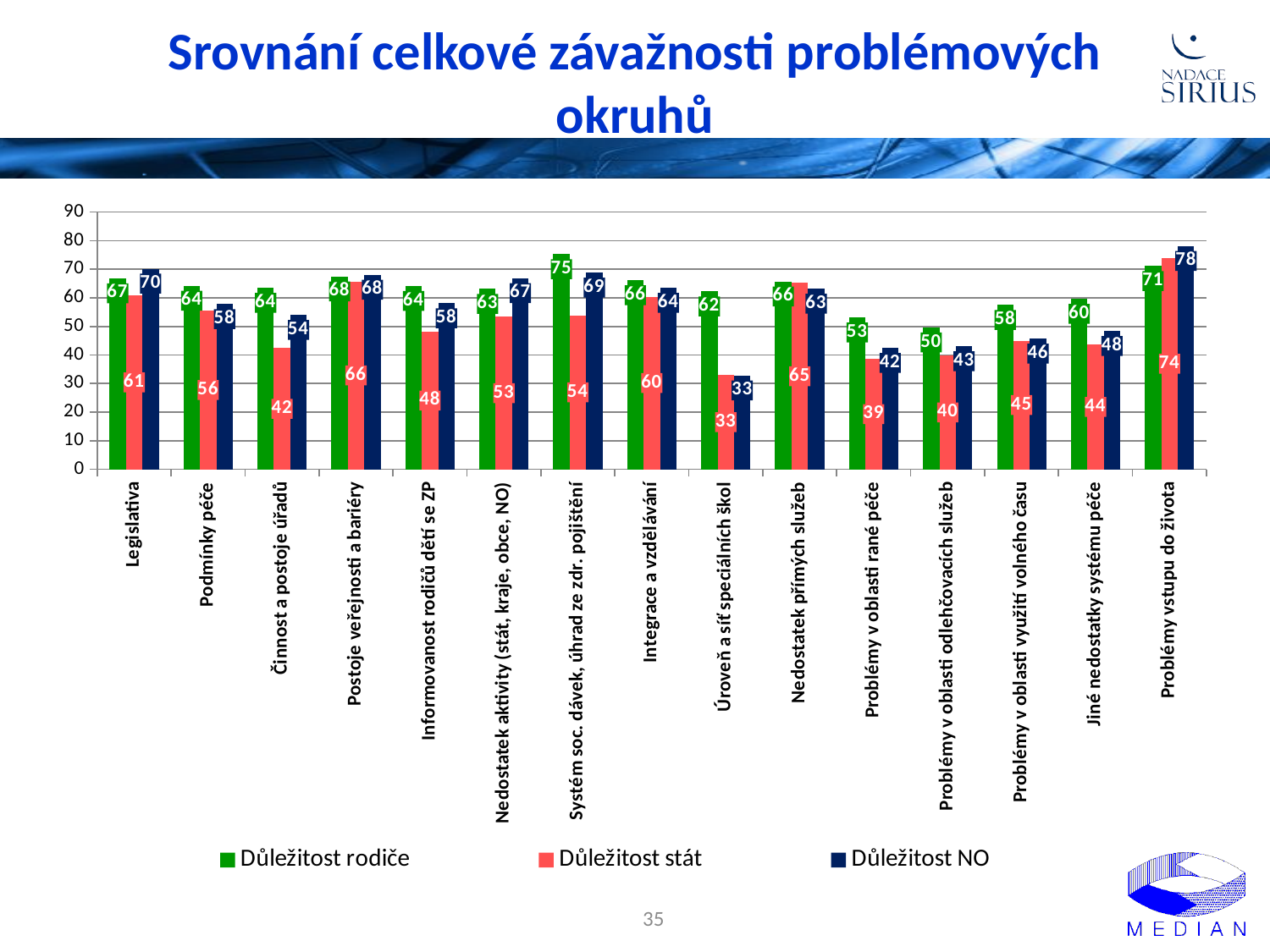
Is the value of Důležitost stát for Informovanost rodičů dětí se ZP greater or less than 50? less What is the value of Důležitost NO for Problémy vstupu do života? 78 What is the value of Důležitost rodiče for Legislativa? 67 What is the value of Důležitost stát for Činnost a postoje úřadů? 42 How many categories are shown on the x axis? 15 Which category has the lowest value for Důležitost rodiče? Problémy v oblasti odlehčovacích služeb What kind of chart is shown on the slide? bar chart Which category has the lowest value for Důležitost stát? Úroveň a síť speciálních škol What is the difference between Důležitost rodiče and Důležitost stát for Úroveň a síť speciálních škol? 29 For Podmínky péče, which is larger: Důležitost stát or Důležitost NO? Důležitost NO How many series does the legend list? 3 Which category has the highest value for Důležitost rodiče? Systém soc. dávek, úhrad ze zdr. pojištění